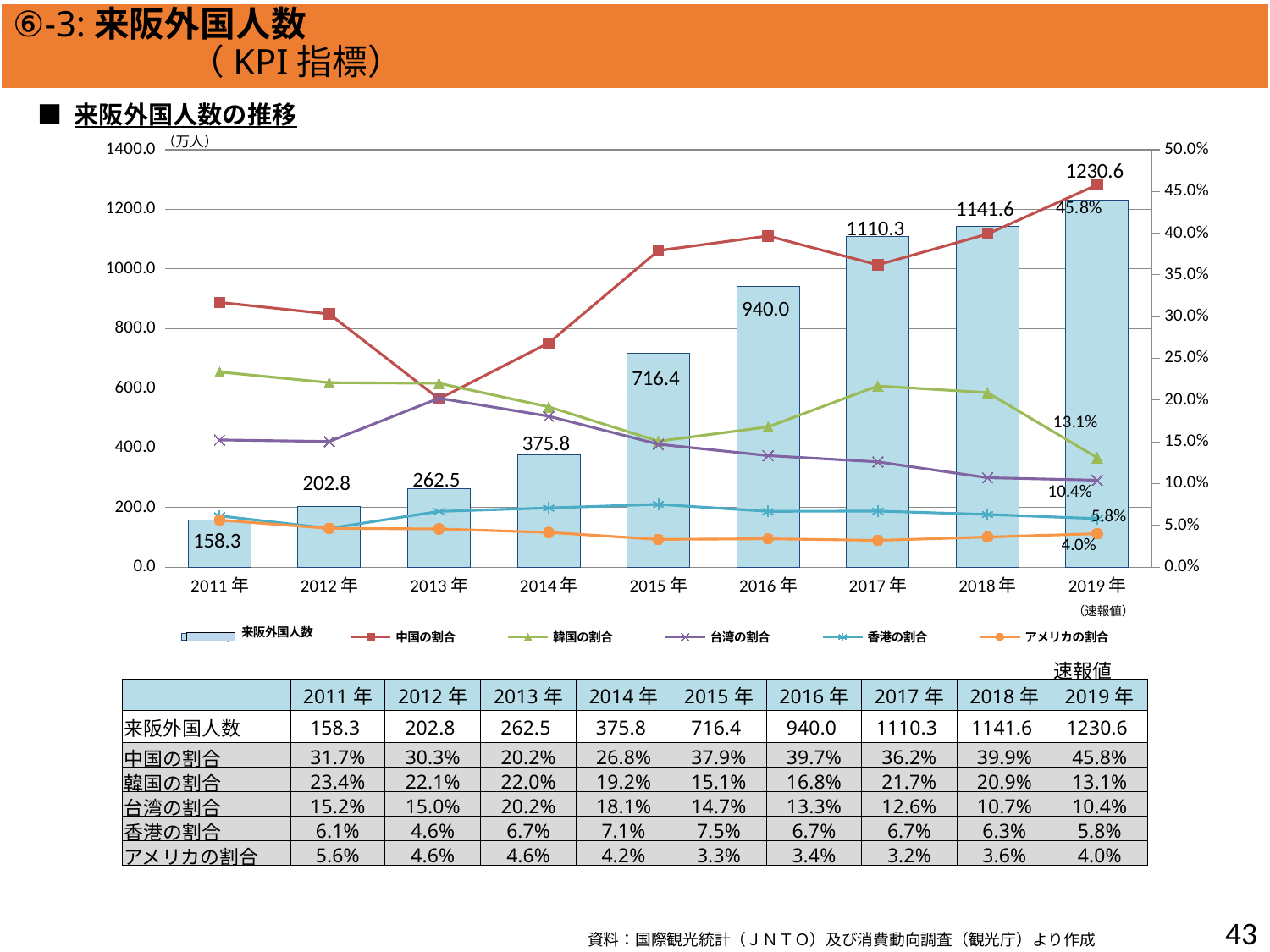
Which year has the highest 来阪外国人数? 2019年 Which year has the lowest 来阪外国人数? 2011年 What is the difference in 来阪外国人数 between 2019年 and 2018年? 89.0 Which year has a larger 来阪外国人数, 2014年 or 2015年? 2015年 What is the 韓国の割合 value for 2019年? 13.1% What kind of chart is used to show 来阪外国人数の推移? Combined bar and line chart What unit is shown for the left axis of the chart? 万人 Do the 来阪外国人数 bars rise or fall from 2011年 to 2019年? Rise What is the value of 来阪外国人数 for 2016年? 940.0 What is the 中国の割合 value for 2019年? 45.8% How many years are shown on the x axis of the chart? 9 How many series does the chart legend list? 6